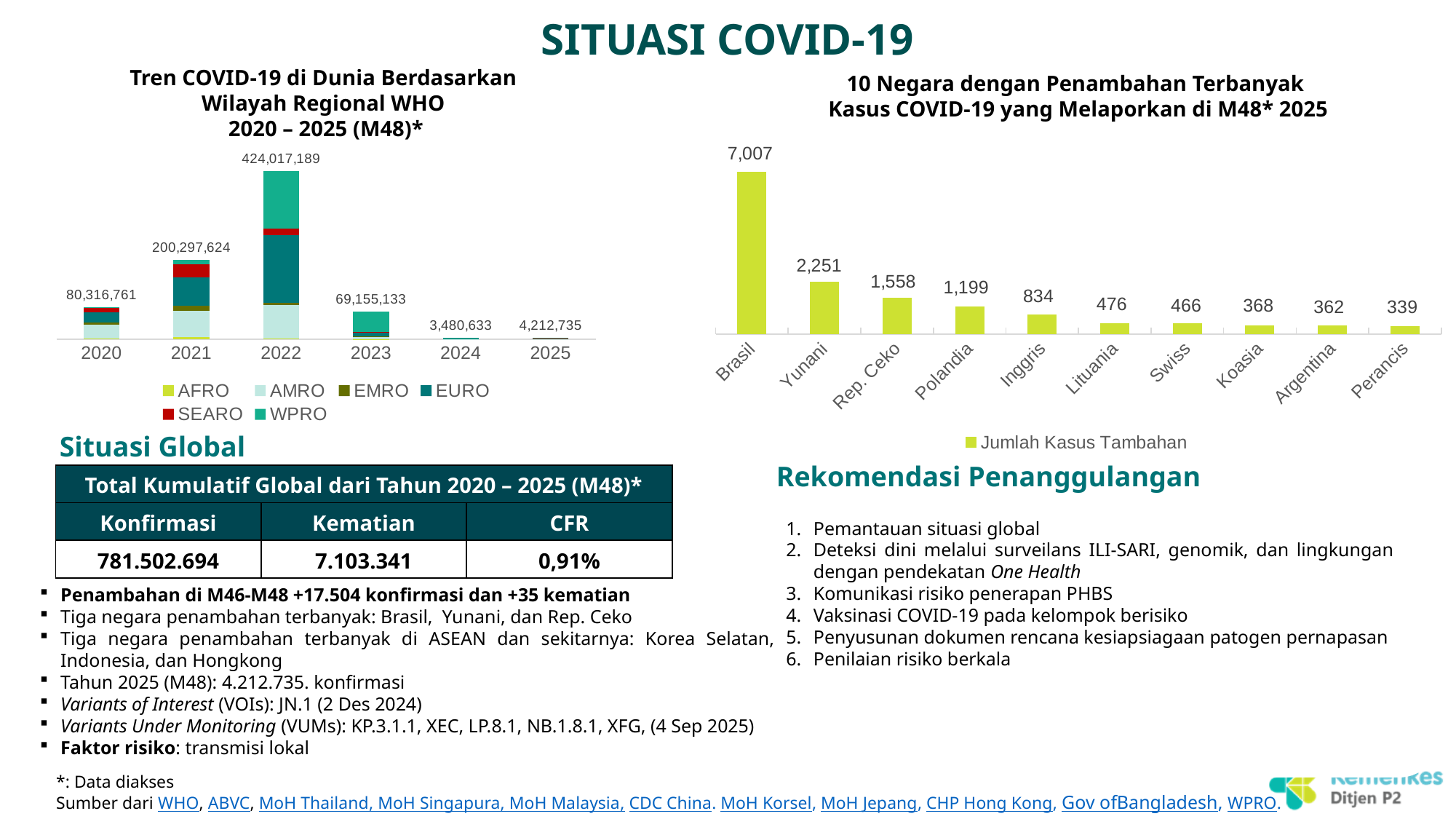
In the chart 'Tren COVID-19 di Dunia Berdasarkan Wilayah Regional WHO 2020 – 2025 (M48)*', which year has the highest total? 2022 In the chart 'Tren COVID-19 di Dunia Berdasarkan Wilayah Regional WHO 2020 – 2025 (M48)*', which total is larger, 2020 or 2023? 2020 What kind of chart is 'Tren COVID-19 di Dunia Berdasarkan Wilayah Regional WHO 2020 – 2025 (M48)*'? Stacked bar chart In the chart '10 Negara dengan Penambahan Terbanyak Kasus COVID-19 yang Melaporkan di M48* 2025', what is the value for Brasil? 7,007 In the chart 'Tren COVID-19 di Dunia Berdasarkan Wilayah Regional WHO 2020 – 2025 (M48)*', what is the total labeled for 2022? 424,017,189 In the chart 'Tren COVID-19 di Dunia Berdasarkan Wilayah Regional WHO 2020 – 2025 (M48)*', how many series does the legend list? 6 In the chart '10 Negara dengan Penambahan Terbanyak Kasus COVID-19 yang Melaporkan di M48* 2025', what is the value for Polandia? 1,199 In the chart '10 Negara dengan Penambahan Terbanyak Kasus COVID-19 yang Melaporkan di M48* 2025', which country has the lowest value? Perancis In the chart '10 Negara dengan Penambahan Terbanyak Kasus COVID-19 yang Melaporkan di M48* 2025', what is the legend entry? Jumlah Kasus Tambahan In the chart 'Tren COVID-19 di Dunia Berdasarkan Wilayah Regional WHO 2020 – 2025 (M48)*', what is the total labeled for 2024? 3,480,633 In the chart '10 Negara dengan Penambahan Terbanyak Kasus COVID-19 yang Melaporkan di M48* 2025', what is the difference between the values for Yunani and Rep. Ceko? 693 In the chart '10 Negara dengan Penambahan Terbanyak Kasus COVID-19 yang Melaporkan di M48* 2025', how many countries are shown? 10